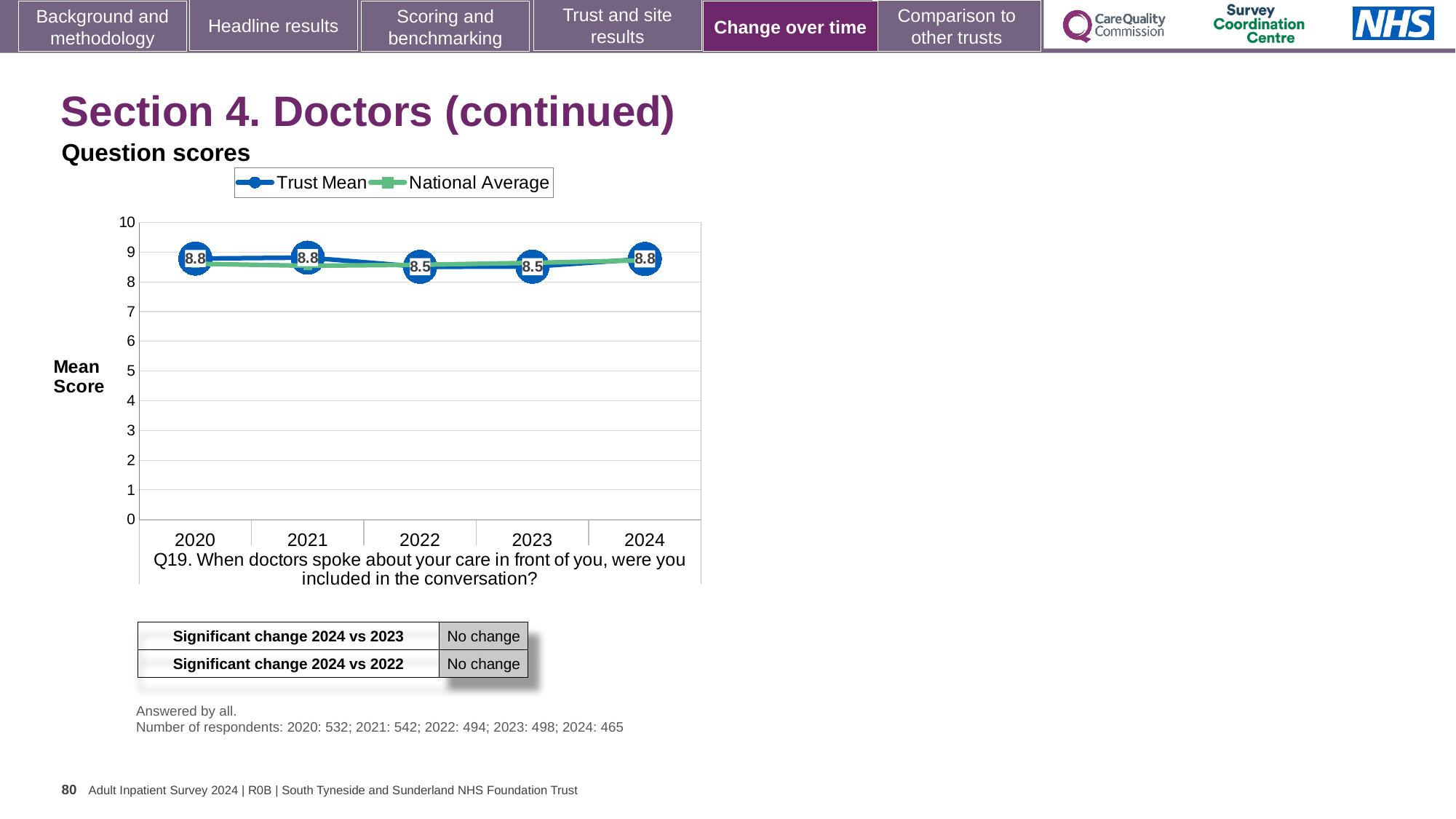
What is the difference between the Trust Mean scores for 2021 and 2022? 0.3 How many years are shown on the x axis of the chart? 5 What is the Trust Mean score for 2023? 8.5 What is the Trust Mean score for 2024? 8.8 What is the Trust Mean score for 2020? 8.8 What is the label of the y axis of the chart? Mean Score Does the Trust Mean score rise or fall from 2021 to 2022? fall Is the National Average value for 2020 greater or less than 8? greater What is the Trust Mean score for 2022? 8.5 Which year has the larger Trust Mean score, 2021 or 2023? 2021 What kind of chart is shown on the slide? line chart How many series does the legend list? 2